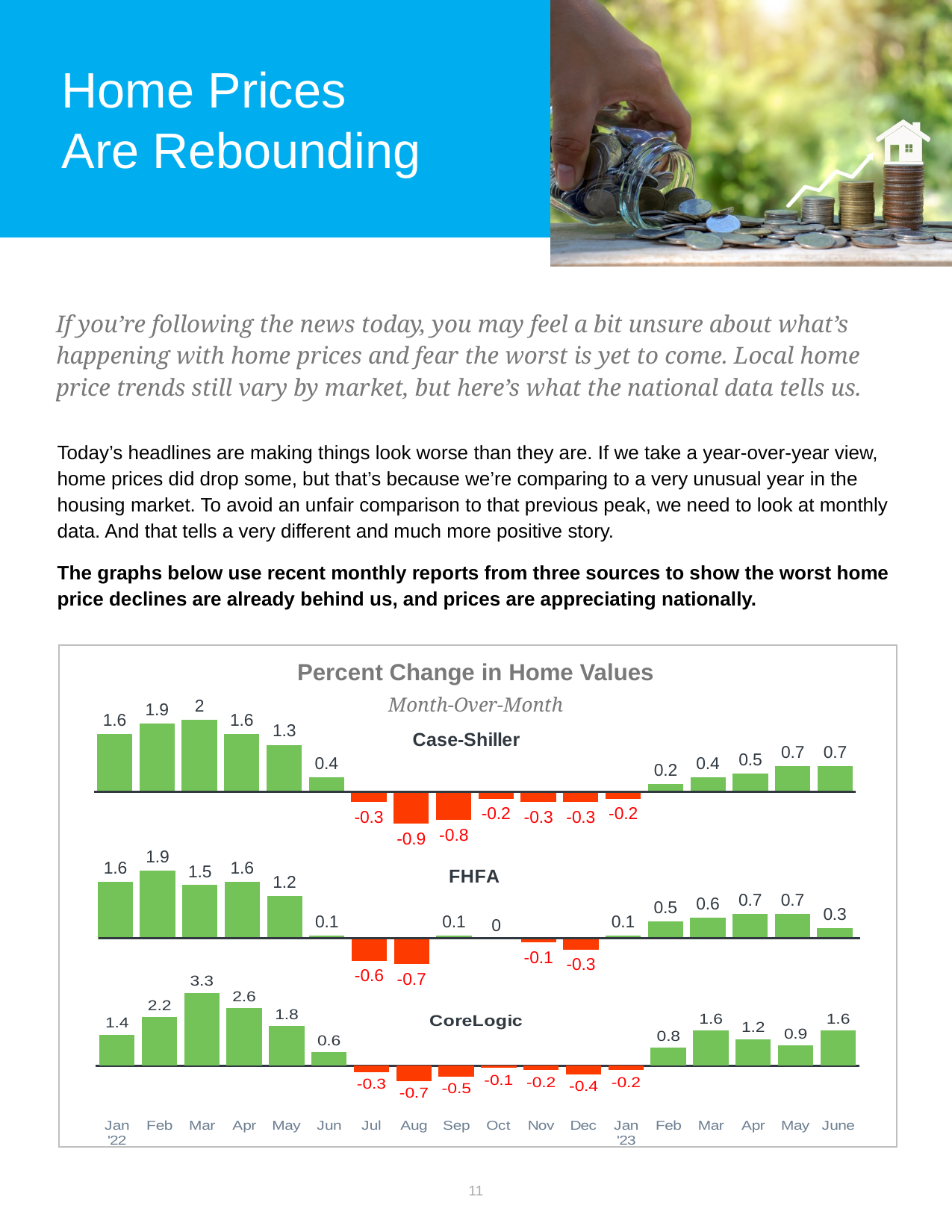
In the FHFA chart, what is the value for Feb '23? 0.5 What kind of chart is used to show the Percent Change in Home Values? Bar chart How many months are shown on the x axis of each chart? 18 In the Case-Shiller chart, what is the difference between the values for Mar '22 and Jun? 1.6 In the CoreLogic chart, what is the value for Mar '22? 3.3 In the CoreLogic chart, which is larger, the value for Feb '23 or the value for Mar '23? Mar '23 In the FHFA chart, which month has the lowest value? Aug In the Case-Shiller chart, which month has the lowest value? Aug What is the subtitle of the Percent Change in Home Values chart? Month-Over-Month In the Case-Shiller chart, what is the value for Aug? -0.9 In the Case-Shiller chart, do the values rise or fall from Jan '23 to June? Rise In the CoreLogic chart, which month has the highest value? Mar '22